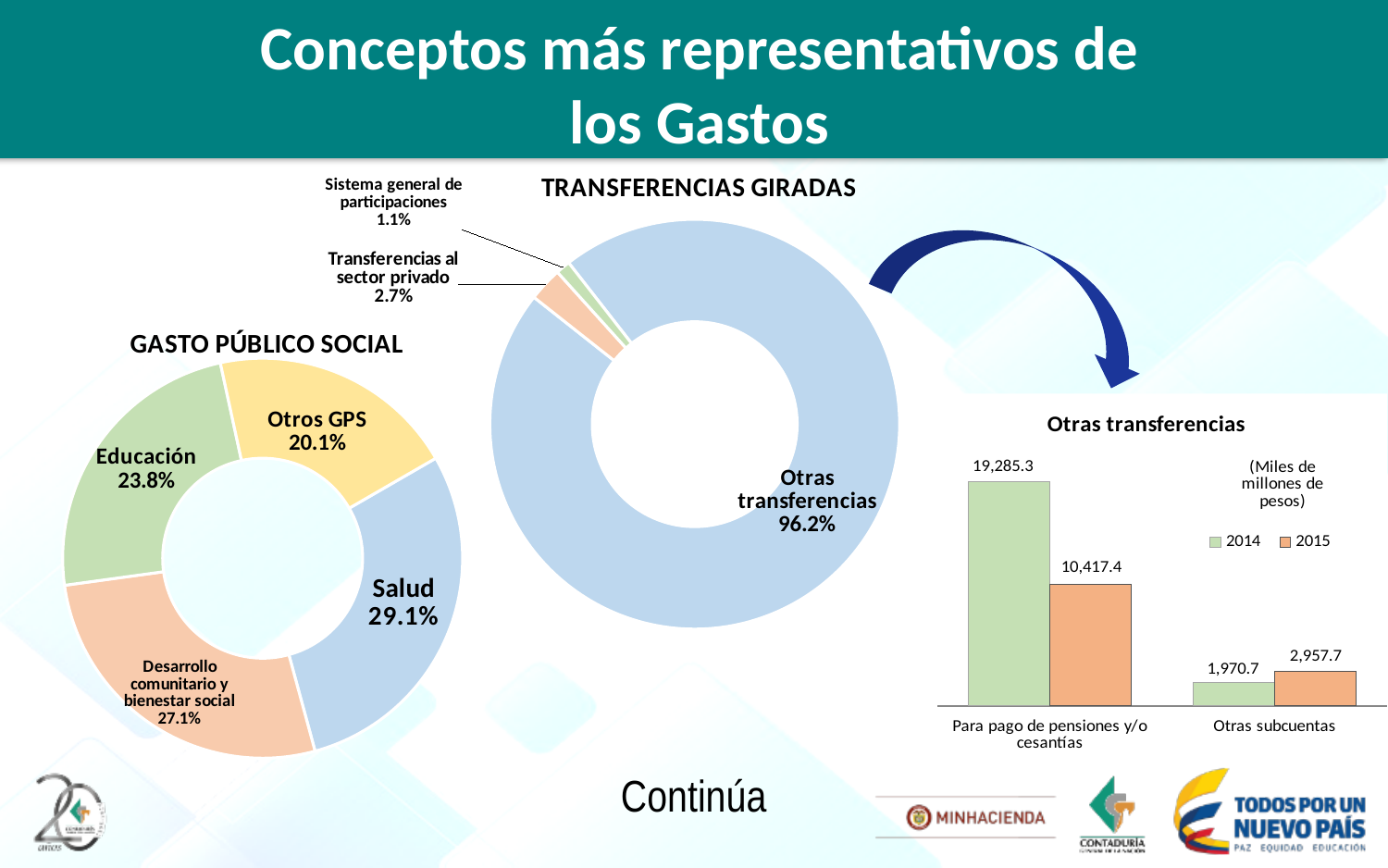
In the GASTO PÚBLICO SOCIAL chart, what is the difference in percentage points between Salud and Educación? 5.3 In the Otras transferencias chart, how many series does the legend list? 2 In the Otras transferencias chart, which is larger for Otras subcuentas, the 2014 value or the 2015 value? 2015 In the TRANSFERENCIAS GIRADAS chart, which category has the smallest share? Sistema general de participaciones In the Otras transferencias chart, what is the difference between the 2014 and 2015 values for Para pago de pensiones y/o cesantías? 8,867.9 In the GASTO PÚBLICO SOCIAL chart, what share does Salud represent? 29.1% In the TRANSFERENCIAS GIRADAS chart, what share do Otras transferencias represent? 96.2% What kind of chart is the TRANSFERENCIAS GIRADAS chart? Donut (pie) chart In the GASTO PÚBLICO SOCIAL chart, which category has the smallest share? Otros GPS In the Otras transferencias chart, what is the 2014 value for Para pago de pensiones y/o cesantías? 19,285.3 In the GASTO PÚBLICO SOCIAL chart, how many categories are shown? 4 In the GASTO PÚBLICO SOCIAL chart, which category has the largest share? Salud